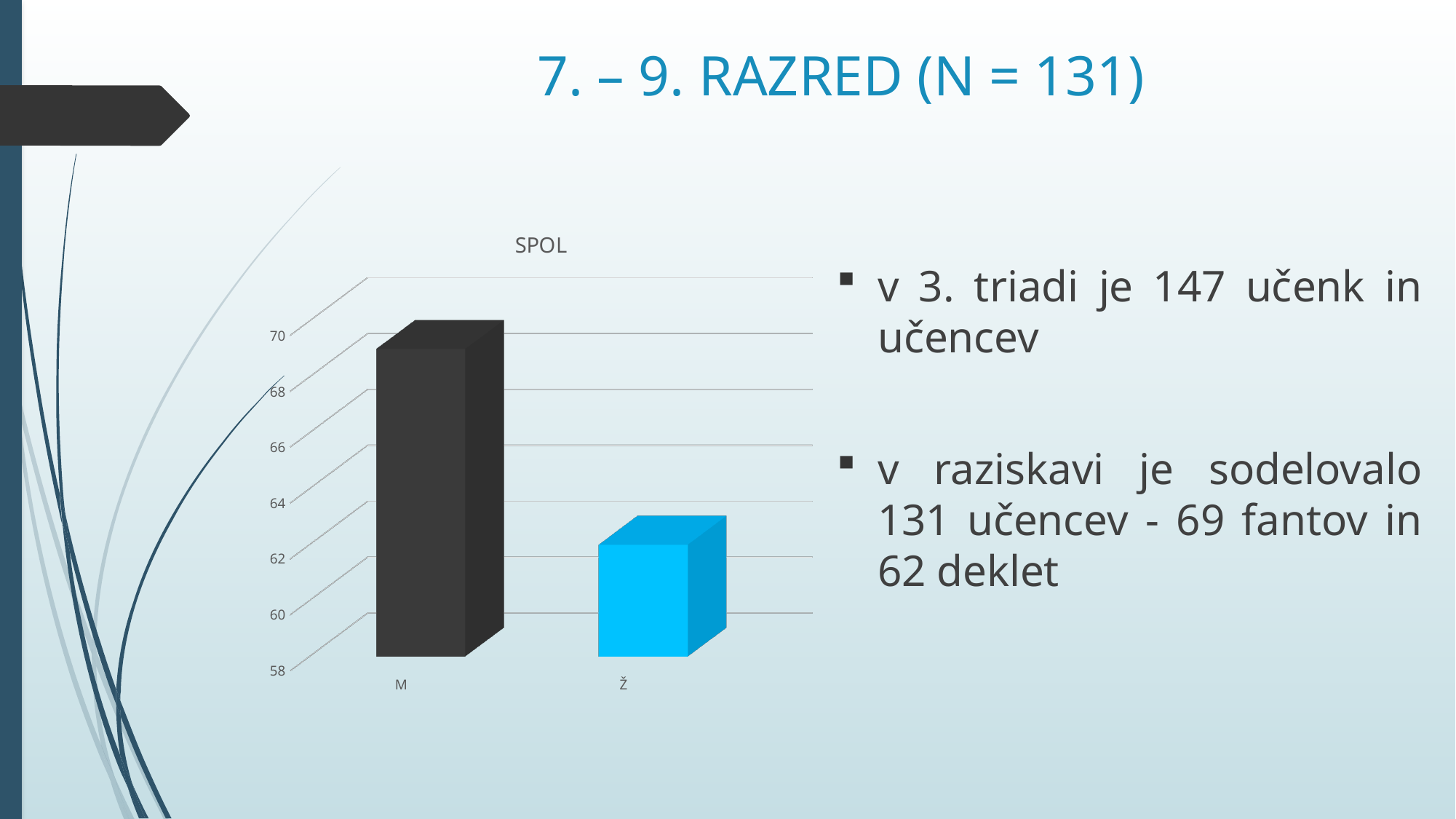
Is the value for Ž greater or less than 64? less What is the title of the chart? SPOL How many categories are shown on the x axis of the chart? 2 Is the value for Ž greater or less than 60? greater Which category has the highest bar in the chart? M Which bar is taller, M or Ž? M What kind of chart is shown on the slide? bar chart What is the highest value labelled on the vertical axis of the chart? 70 Is the value for M greater or less than 66? greater What colour is the bar for Ž? blue Which category has the lowest bar in the chart? Ž